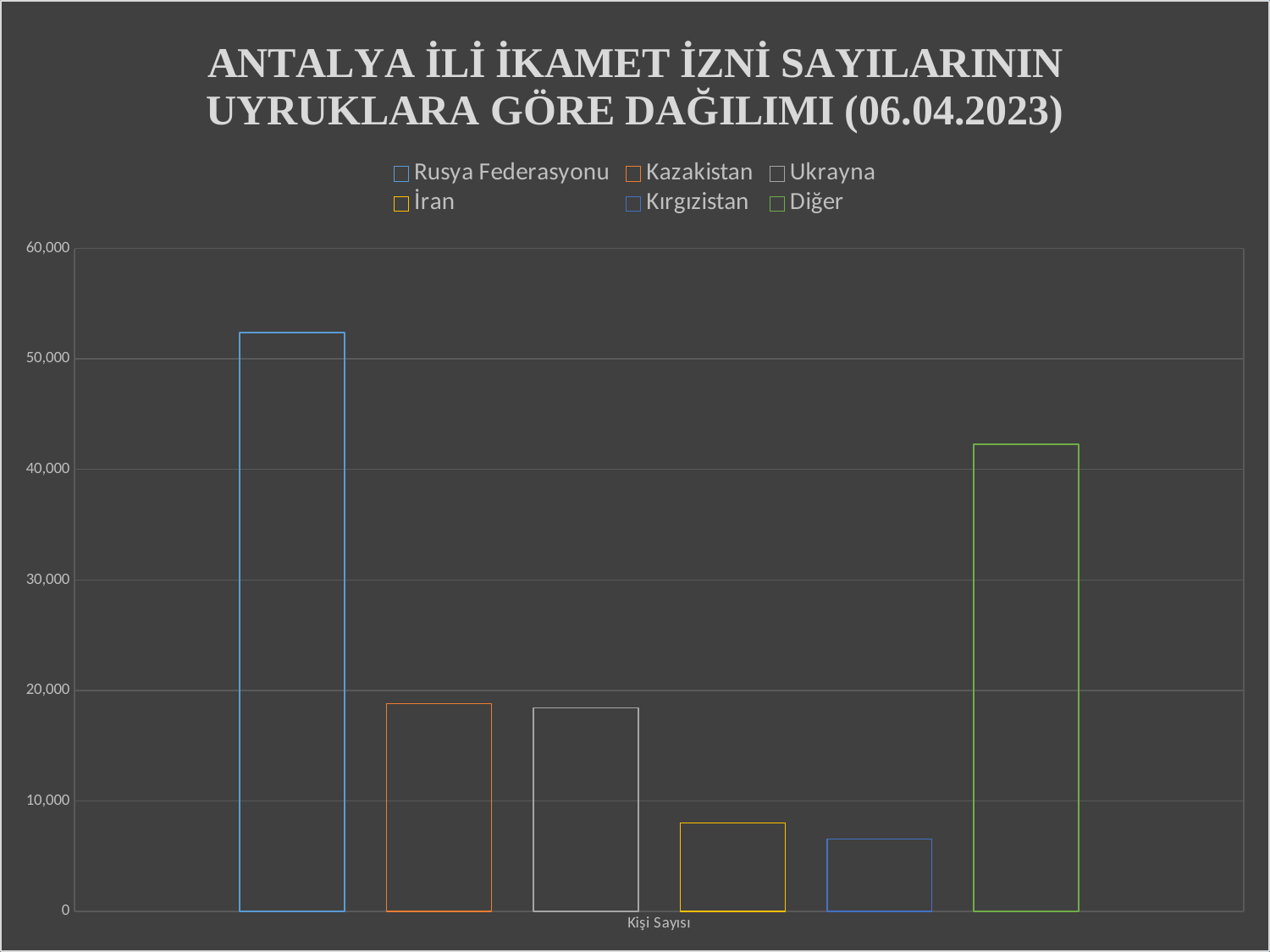
How many series does the legend list? 6 Is the value for Rusya Federasyonu greater or less than 50,000? greater Which nationality has the lowest number of residence permits? Kırgızistan Is the value for Diğer greater or less than 40,000? greater Which is larger, the value for Diğer or the value for Kazakistan? Diğer Which nationality has the highest number of residence permits? Rusya Federasyonu Is the value for Kazakistan greater or less than 20,000? less What is the label shown on the horizontal axis of the chart? Kişi Sayısı What kind of chart is shown on the slide? bar chart How many bars are plotted on the chart? 6 Which is larger, the value for İran or the value for Kırgızistan? İran